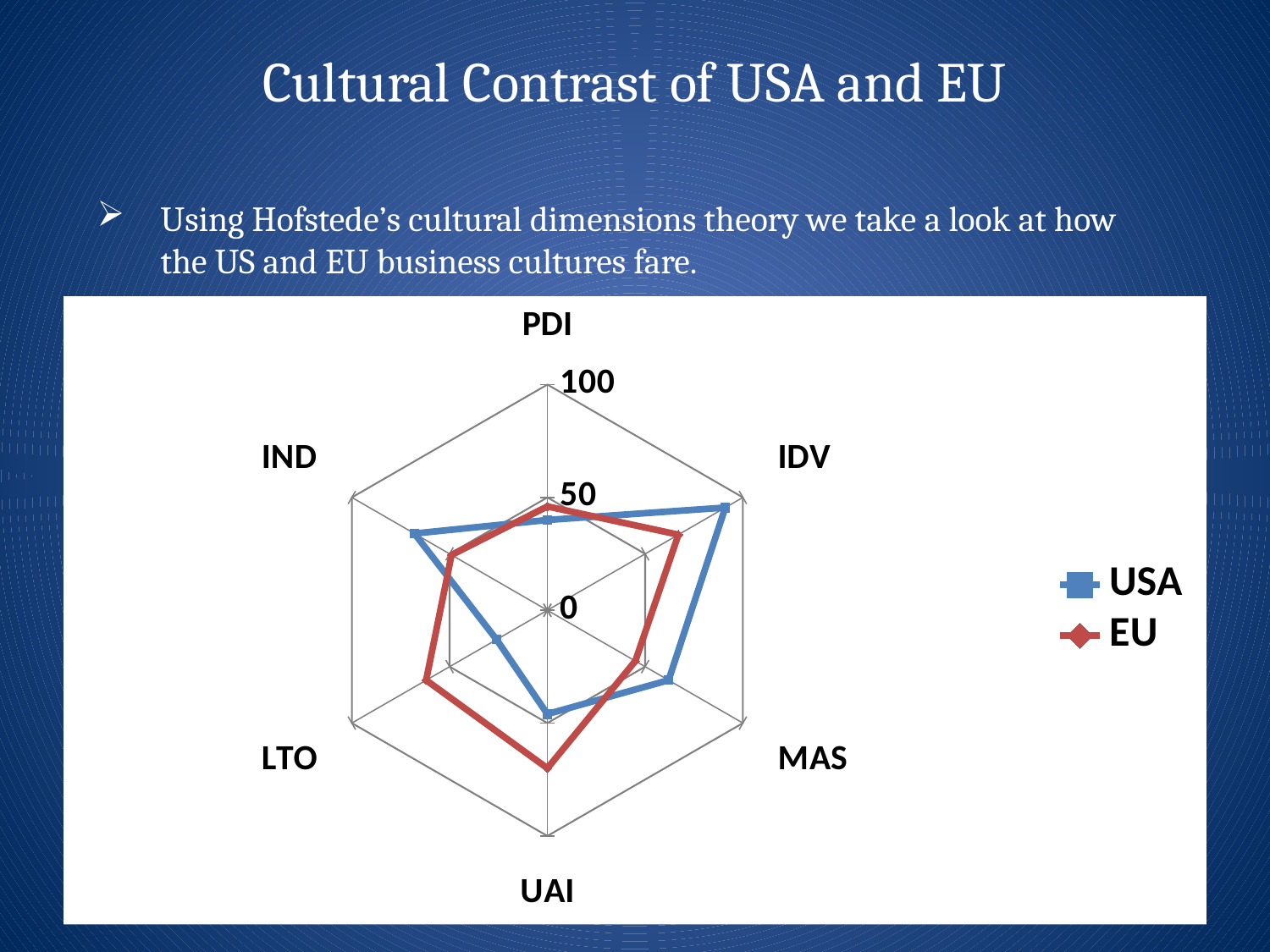
Which series is drawn in red? EU Is the USA value for IDV greater or less than 50? greater Is the USA value for LTO greater or less than 50? less Is the EU value for UAI greater or less than 50? greater How many series does the legend list? 2 How many cultural dimensions (axes) are plotted on the chart? 6 Which series has the larger value for LTO, USA or EU? EU Which series has the larger value for IDV, USA or EU? USA For the USA series, which dimension has the highest value? IDV For the USA series, which dimension has the lowest value? LTO What kind of chart is shown on the slide? Radar chart Which series is drawn in blue? USA